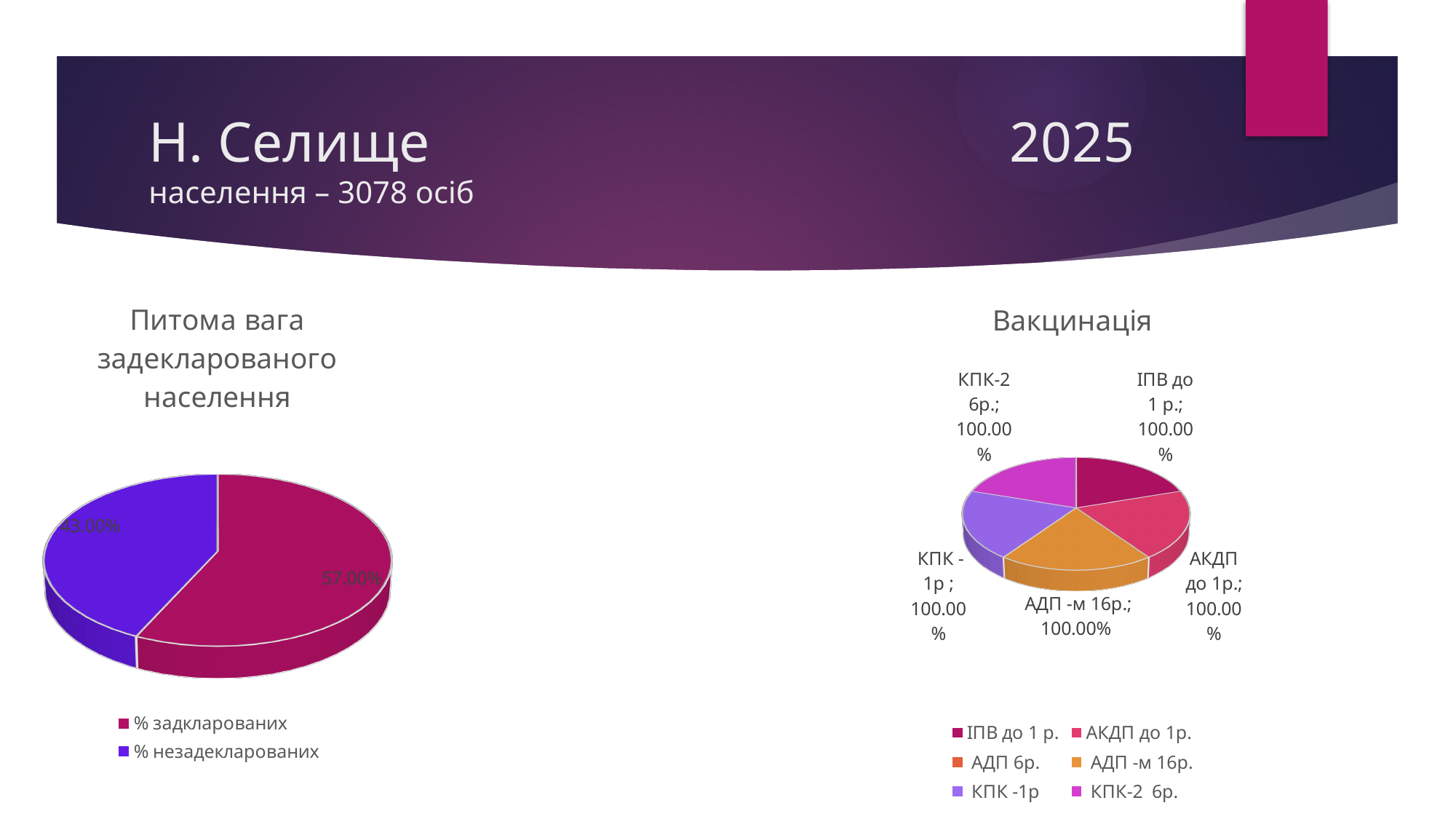
What type of chart is the chart titled "Вакцинація"? Pie chart In the chart titled "Питома вага задекларованого населення", how many entries does the legend list? 2 In the chart titled "Питома вага задекларованого населення", which category has the larger share? % задкларованих What type of chart is the chart titled "Питома вага задекларованого населення"? Pie chart In the chart titled "Вакцинація", what is the value shown for "АДП -м 16р."? 100.00% In the chart titled "Вакцинація", what is the value shown for "ІПВ до 1 р."? 100.00% In the chart titled "Питома вага задекларованого населення", what is the value for "% задкларованих"? 57.00% In the chart titled "Питома вага задекларованого населення", what is the difference between "% задкларованих" and "% незадекларованих"? 14.00% In the chart titled "Питома вага задекларованого населення", what is the value for "% незадекларованих"? 43.00% In the chart titled "Вакцинація", how many entries does the legend list? 6 In the chart titled "Вакцинація", how many slices are visible in the pie? 5 In the chart titled "Питома вага задекларованого населення", what colour is the "% незадекларованих" slice? Purple